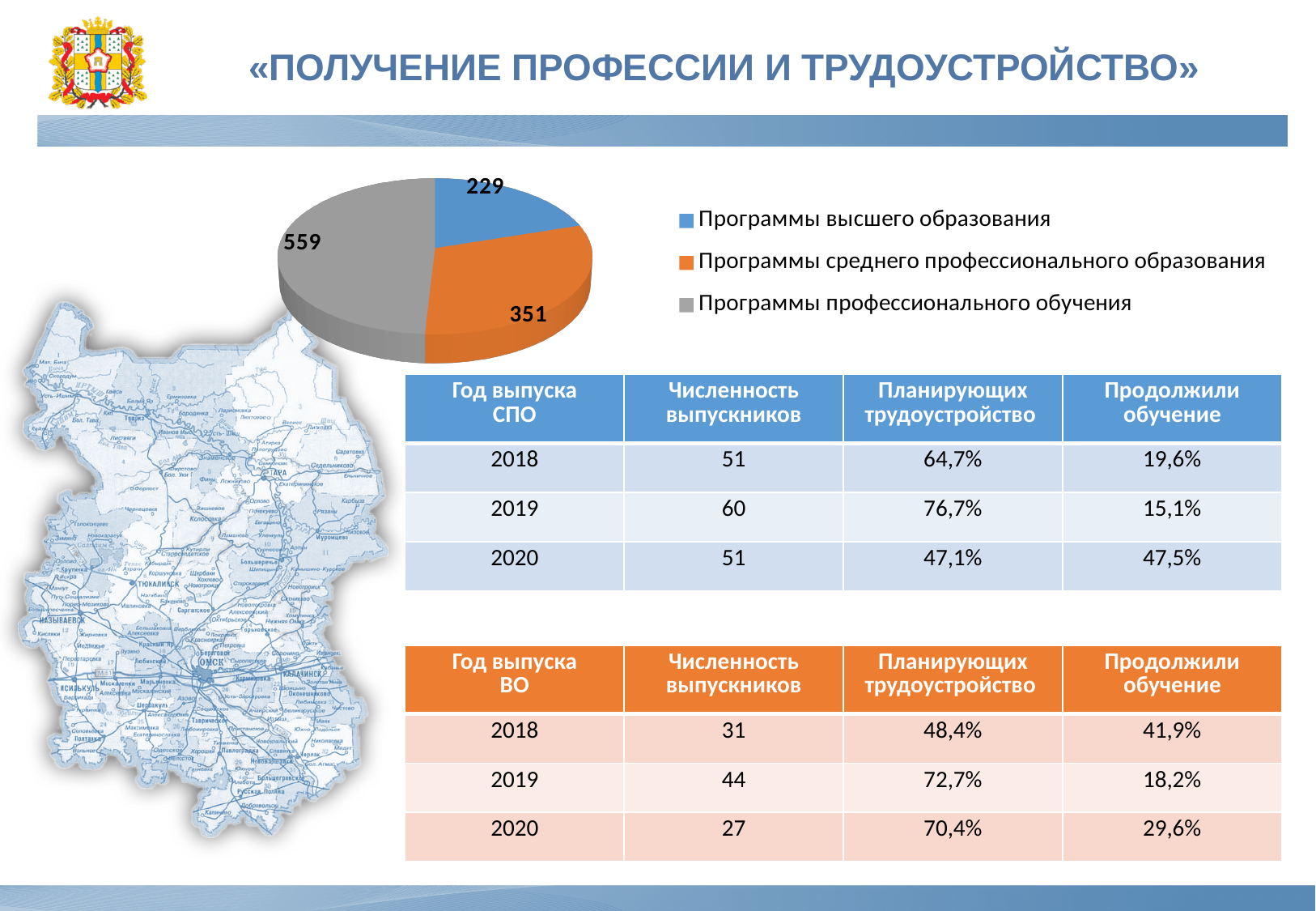
Which category has the largest slice in the pie chart? Программы профессионального обучения What value is shown for «Программы среднего профессионального образования» in the pie chart? 351 What colour represents «Программы профессионального обучения» in the pie chart legend? Grey What value is shown for «Программы профессионального обучения» in the pie chart? 559 Which category has the smallest slice in the pie chart? Программы высшего образования What is the difference between the values for «Программы профессионального обучения» and «Программы среднего профессионального образования» in the pie chart? 208 What is the difference between the values for «Программы среднего профессионального образования» and «Программы высшего образования» in the pie chart? 122 In the pie chart, which is larger: «Программы среднего профессионального образования» or «Программы высшего образования»? Программы среднего профессионального образования How many slices does the pie chart have? 3 What type of chart is shown on the slide? Pie chart What value is shown for «Программы высшего образования» in the pie chart? 229 What is the total of all values shown in the pie chart? 1139